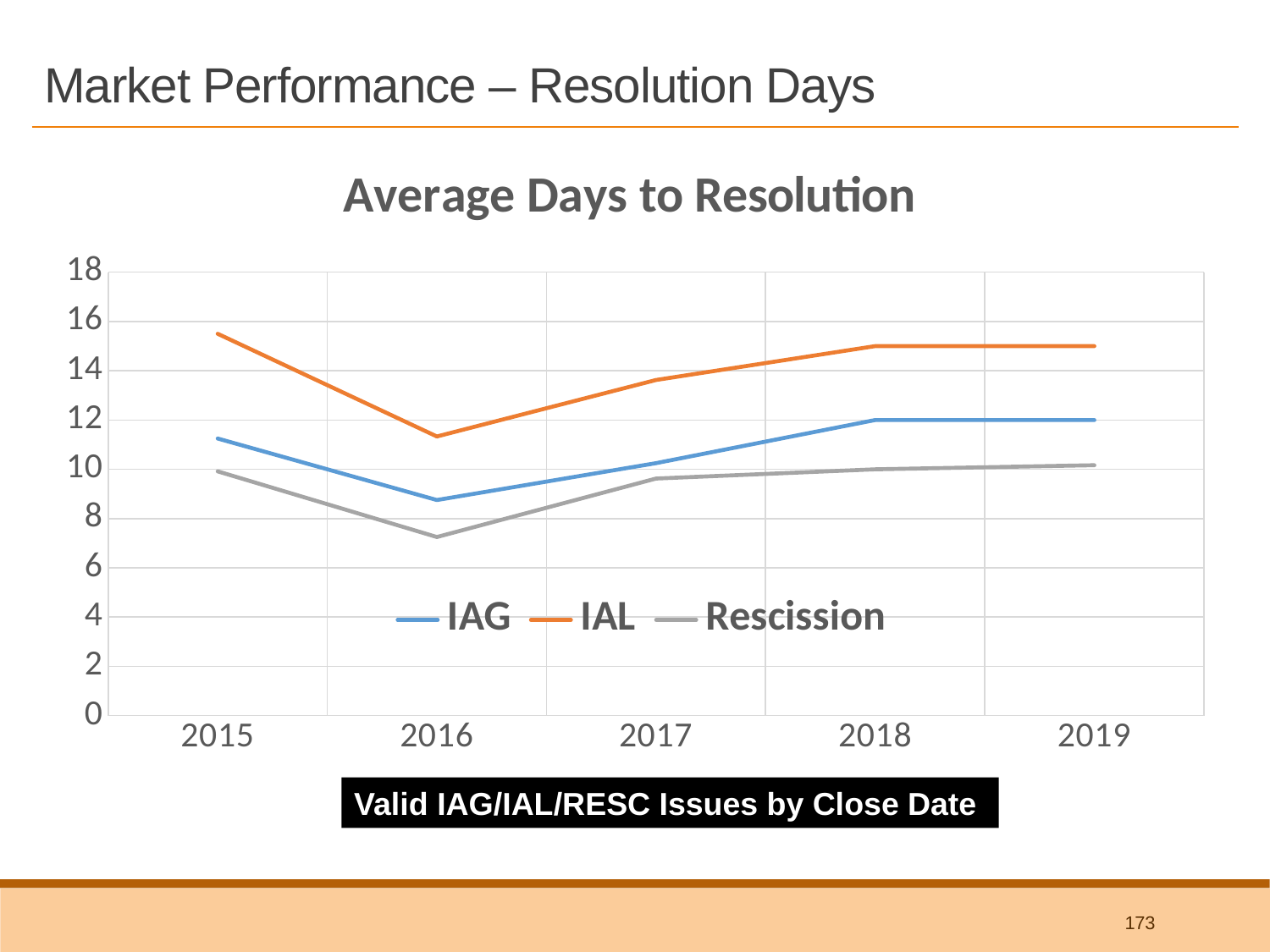
Does the IAL series rise or fall from 2016 to 2018? rise Is the value for Rescission in 2016 greater or less than 8? less What is the title of the chart? Average Days to Resolution How many series does the legend list? 3 Is the value for IAL in 2015 greater or less than 14? greater How many years are plotted along the x axis? 5 Is the value for IAG in 2016 greater or less than 10? less In which year does the IAL series reach its highest value? 2015 In which year does the Rescission series reach its lowest value? 2016 What type of chart is shown on the slide? line chart Which series is drawn in orange? IAL Which series has the larger value in 2017, IAG or IAL? IAL